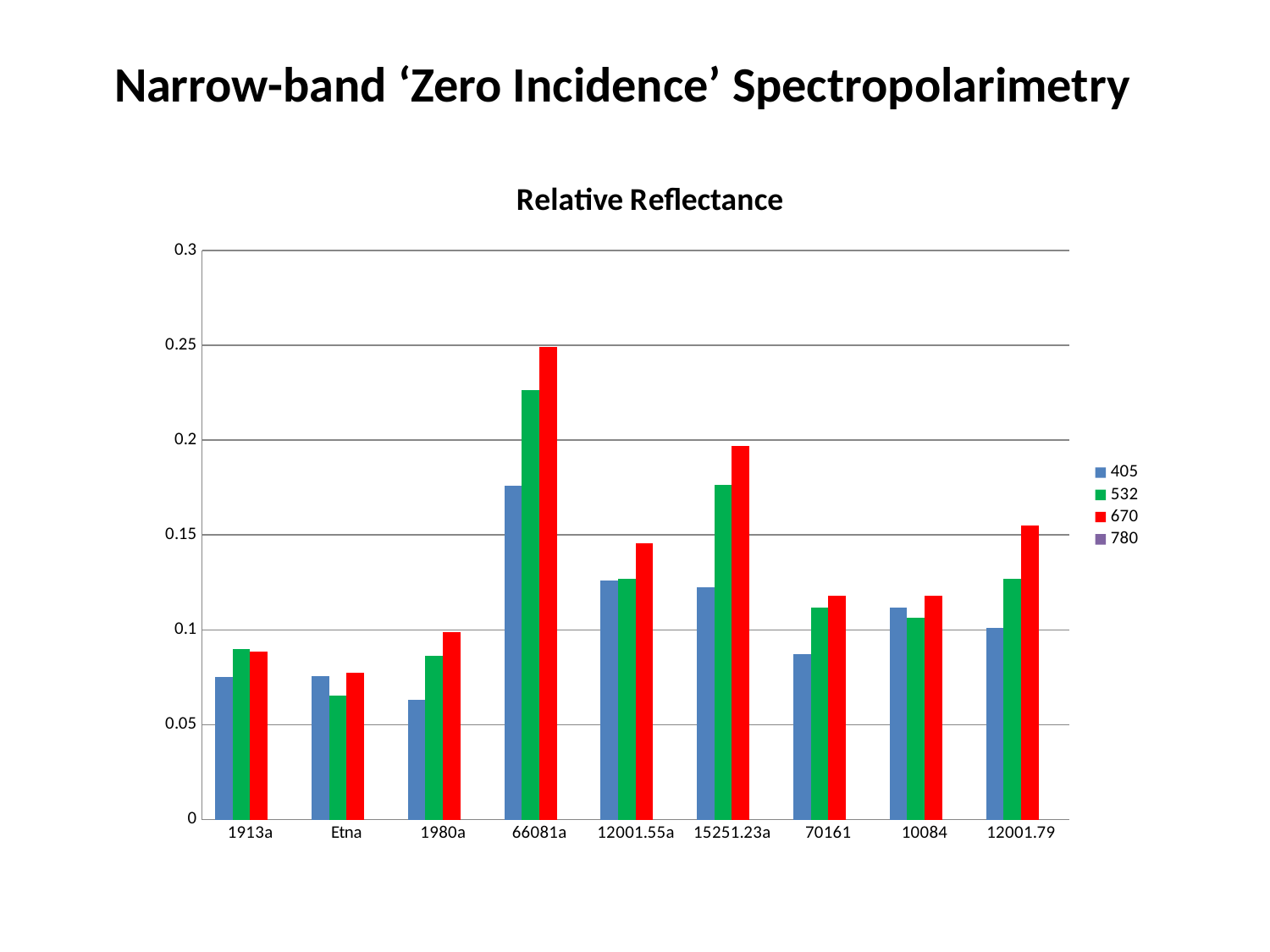
How many categories are shown on the x axis? 9 Which is larger for the 670 series: 66081a or 15251.23a? 66081a Which category has the highest value for the 405 series? 66081a Is the value for 15251.23a in the 670 series greater or less than 0.15? greater Is the value for 66081a in the 670 series greater or less than 0.2? greater Is the value for 1913a in the 405 series greater or less than 0.1? less For 12001.79, which series has the larger value: 405 or 532? 532 Which category has the highest value for the 670 series? 66081a What kind of chart is shown on the slide? bar chart How many series does the legend list? 4 What is the title of the chart? Relative Reflectance